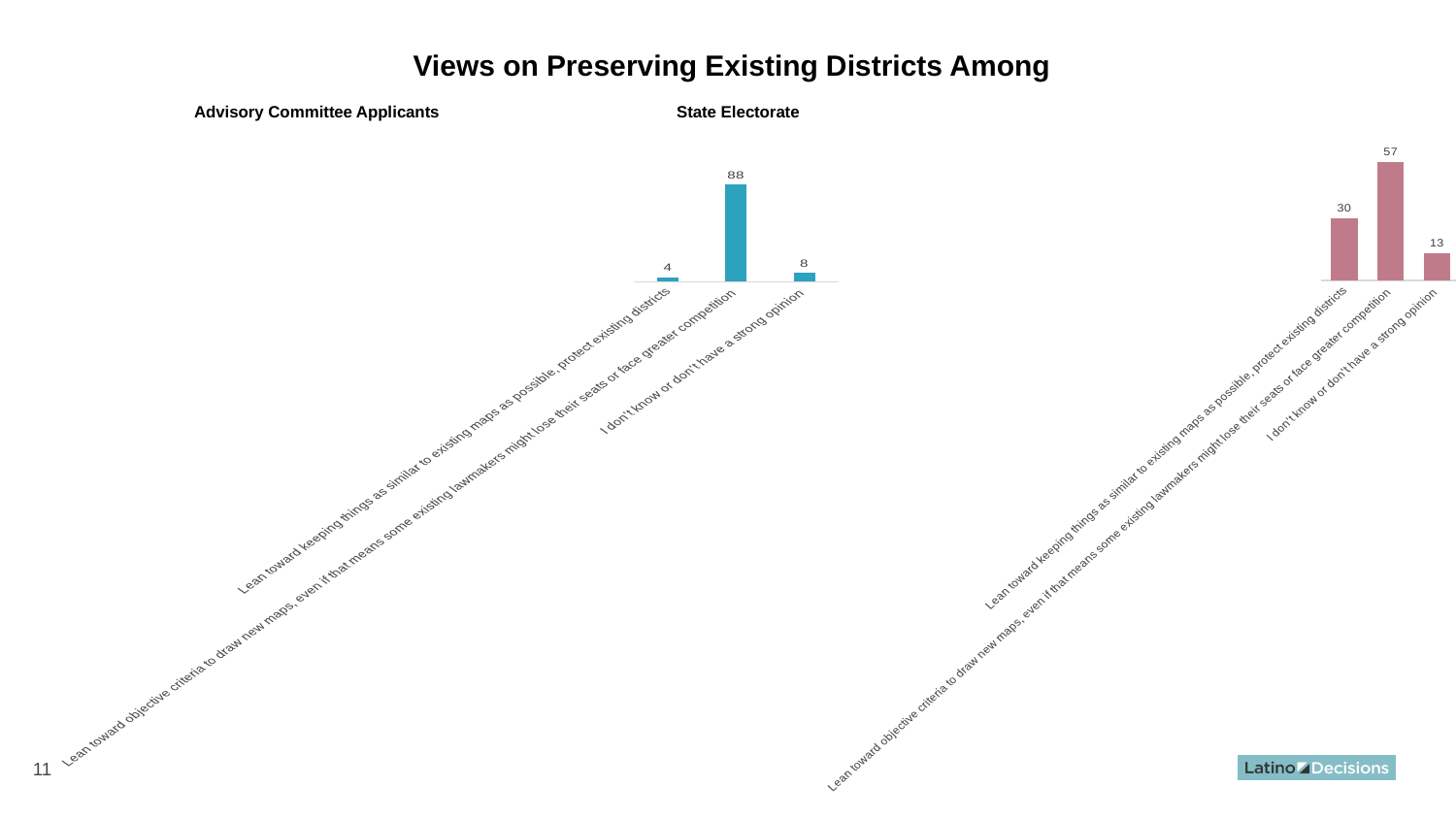
How many categories are shown in the State Electorate chart? 3 In the Advisory Committee Applicants chart, what is the value for "Lean toward keeping things as similar to existing maps as possible, protect existing districts"? 4 In the State Electorate chart, which category has the highest value? Lean toward objective criteria to draw new maps, even if that means some existing lawmakers might lose their seats or face greater competition What type of chart is the Advisory Committee Applicants chart? Bar chart Which chart has the larger value for "Lean toward keeping things as similar to existing maps as possible, protect existing districts": Advisory Committee Applicants or State Electorate? State Electorate In the State Electorate chart, what is the value for "Lean toward keeping things as similar to existing maps as possible, protect existing districts"? 30 In the Advisory Committee Applicants chart, what is the difference between the value for "I don't know or don't have a strong opinion" and the value for "Lean toward keeping things as similar to existing maps as possible..."? 4 In the State Electorate chart, what is the difference between the value for "Lean toward objective criteria..." and the value for "Lean toward keeping things as similar to existing maps as possible..."? 27 In the Advisory Committee Applicants chart, which category has the lowest value? Lean toward keeping things as similar to existing maps as possible, protect existing districts In the State Electorate chart, what is the value for "I don't know or don't have a strong opinion"? 13 In the Advisory Committee Applicants chart, what is the value for "Lean toward objective criteria to draw new maps, even if that means some existing lawmakers might lose their seats or face greater competition"? 88 What is the main title of the slide above the two charts? Views on Preserving Existing Districts Among